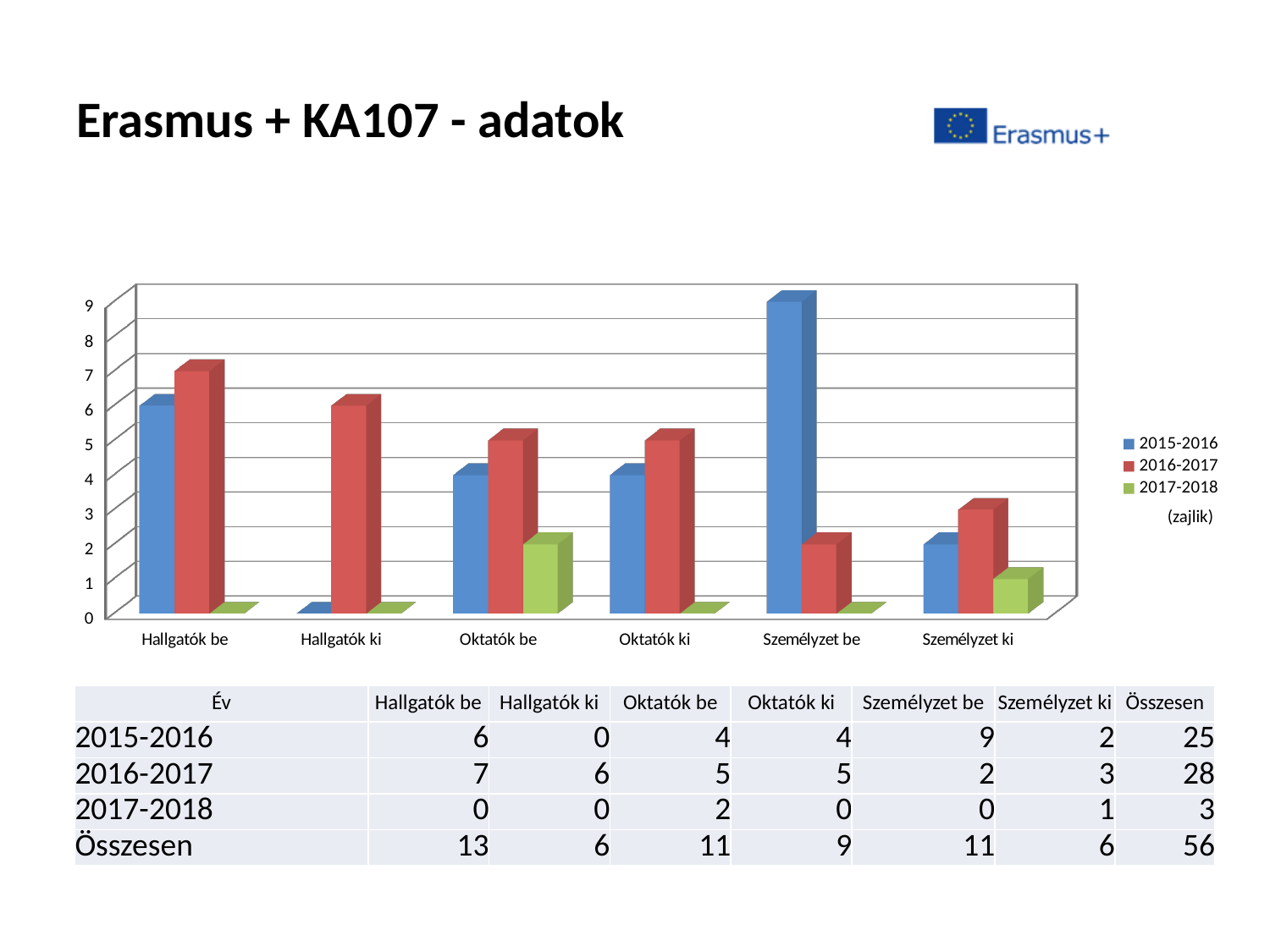
Is the value for Személyzet be in the 2015-2016 series greater or less than 5? greater What is the difference between the 2016-2017 and 2015-2016 values for Hallgatók be? 1 Which category has the lowest value in the 2015-2016 series? Hallgatók ki Which is larger for Személyzet be: the 2015-2016 value or the 2016-2017 value? 2015-2016 What kind of chart is shown on the slide? bar chart Which category has the highest value in the 2015-2016 series? Személyzet be How many series does the chart legend list? 3 Which series in the legend is marked as ongoing (zajlik)? 2017-2018 How many categories are shown on the x axis of the chart? 6 What is the value for Személyzet be in the 2015-2016 series? 9 What is the value for Hallgatók ki in the 2016-2017 series? 6 What is the value for Oktatók be in the 2017-2018 series? 2